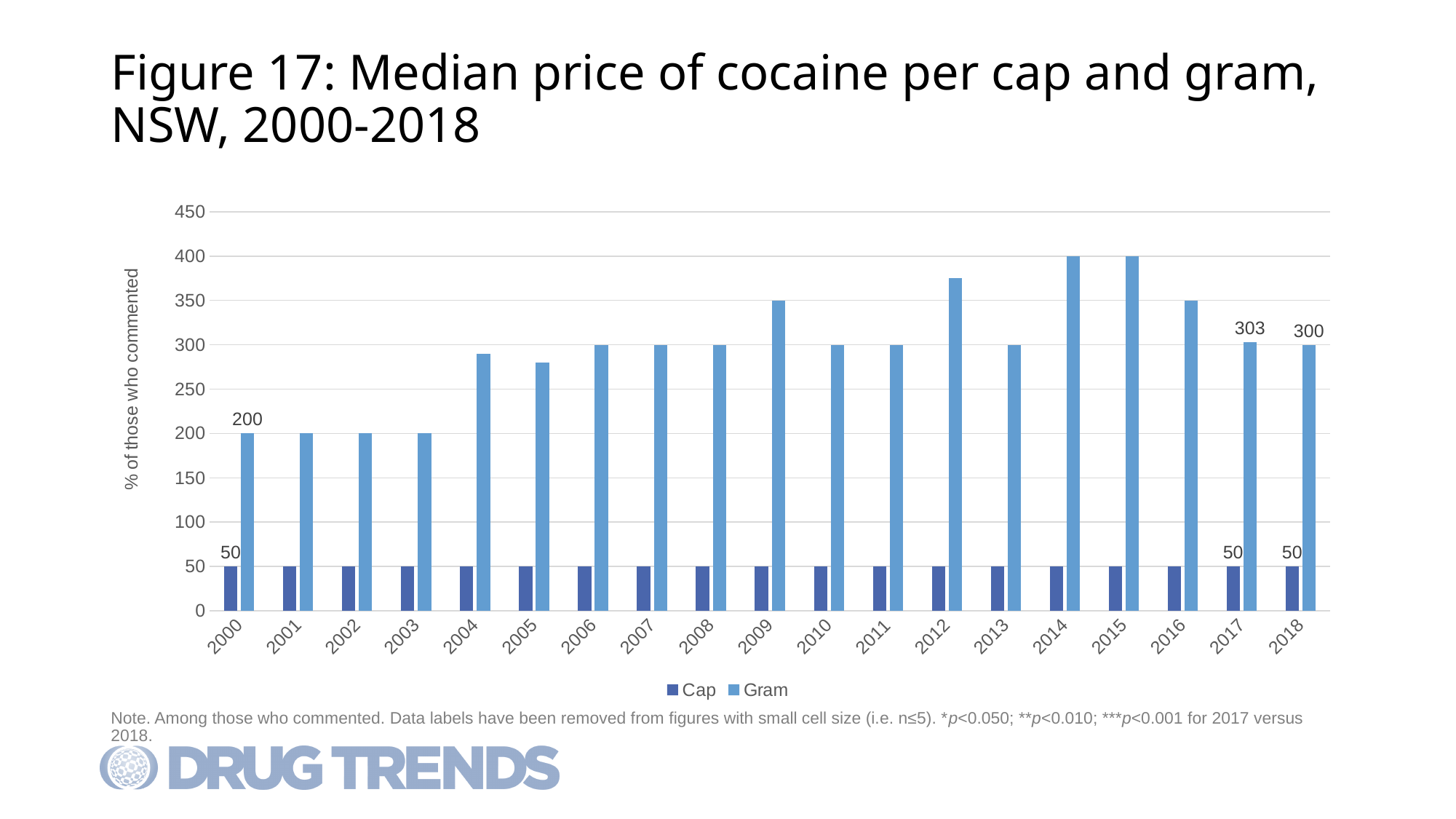
How many years are shown on the x axis? 19 What is the difference between the Gram and Cap values in 2018? 250 What is the Gram value for 2017? 303 What is the Gram value for 2014? 400 Is the Gram value for 2012 greater or less than 350? greater What is the difference between the Gram values for 2017 and 2018? 3 What kind of chart is shown on the slide? bar chart How many series does the legend list? 2 Which year has the larger Gram value, 2017 or 2018? 2017 Is the Gram value for 2005 greater or less than 300? less What is the Cap value for 2018? 50 What is the Gram value for 2000? 200